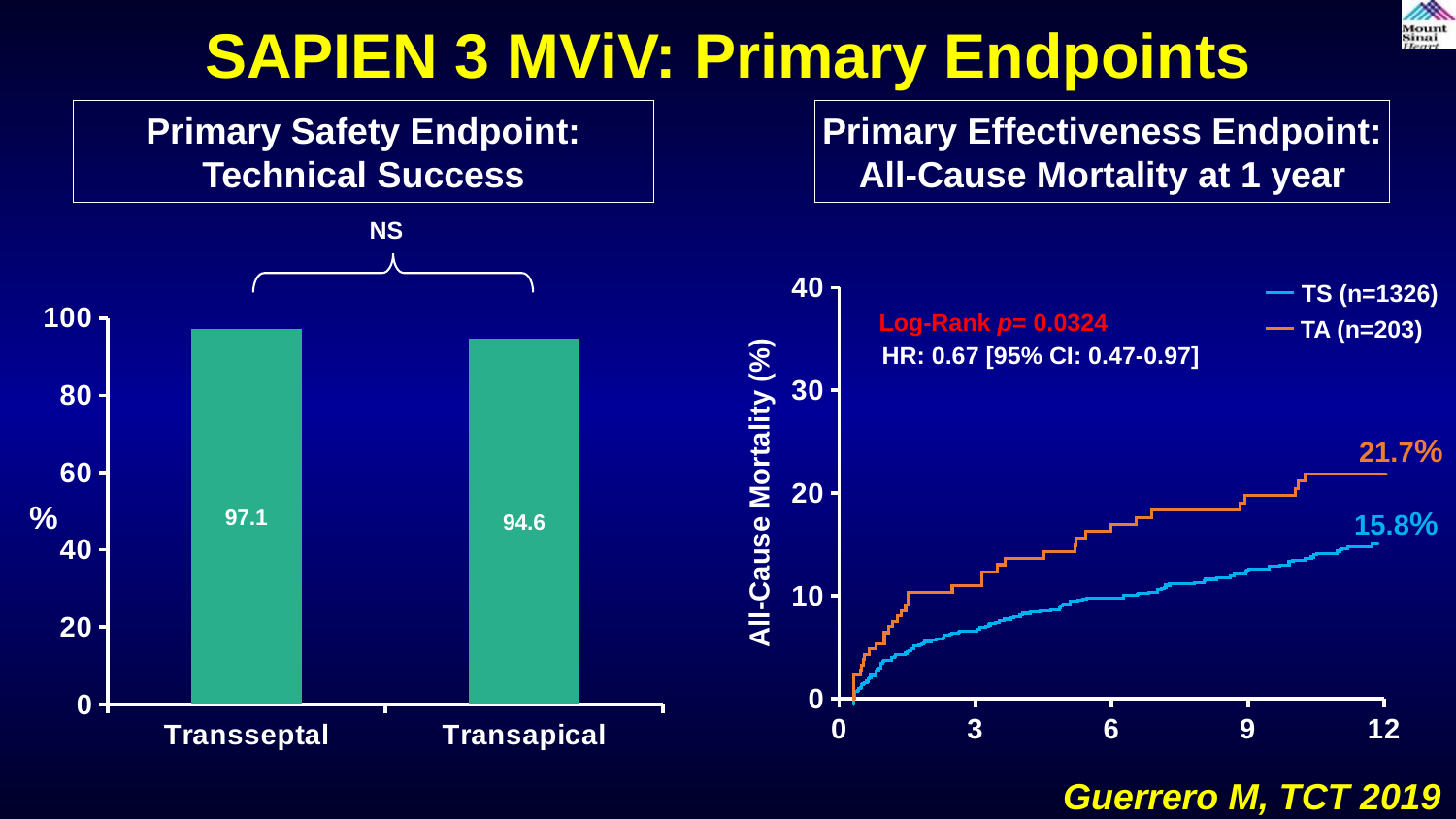
What kind of chart is the Primary Safety Endpoint: Technical Success chart? Bar chart In the Primary Safety Endpoint: Technical Success chart, how many categories are shown on the x axis? 2 In the Primary Effectiveness Endpoint: All-Cause Mortality at 1 year chart, what is the final value labelled for the TA (n=203) curve? 21.7% In the Primary Effectiveness Endpoint: All-Cause Mortality at 1 year chart, which group has the higher mortality at 12 months, TS or TA? TA In the Primary Safety Endpoint: Technical Success chart, which category has the higher value? Transseptal In the Primary Effectiveness Endpoint: All-Cause Mortality at 1 year chart, what is the final value labelled for the TS (n=1326) curve? 15.8% In the Primary Safety Endpoint: Technical Success chart, what is the difference between the Transseptal and Transapical values? 2.5 In the Primary Effectiveness Endpoint: All-Cause Mortality at 1 year chart, do the curves rise or fall as time increases along the x axis? Rise In the Primary Effectiveness Endpoint: All-Cause Mortality at 1 year chart, how many series does the legend list? 2 In the Primary Effectiveness Endpoint: All-Cause Mortality at 1 year chart, what is the difference between the final TA and TS mortality values? 5.9% In the Primary Safety Endpoint: Technical Success chart, what is the value for Transapical? 94.6 In the Primary Safety Endpoint: Technical Success chart, what is the value for Transseptal? 97.1